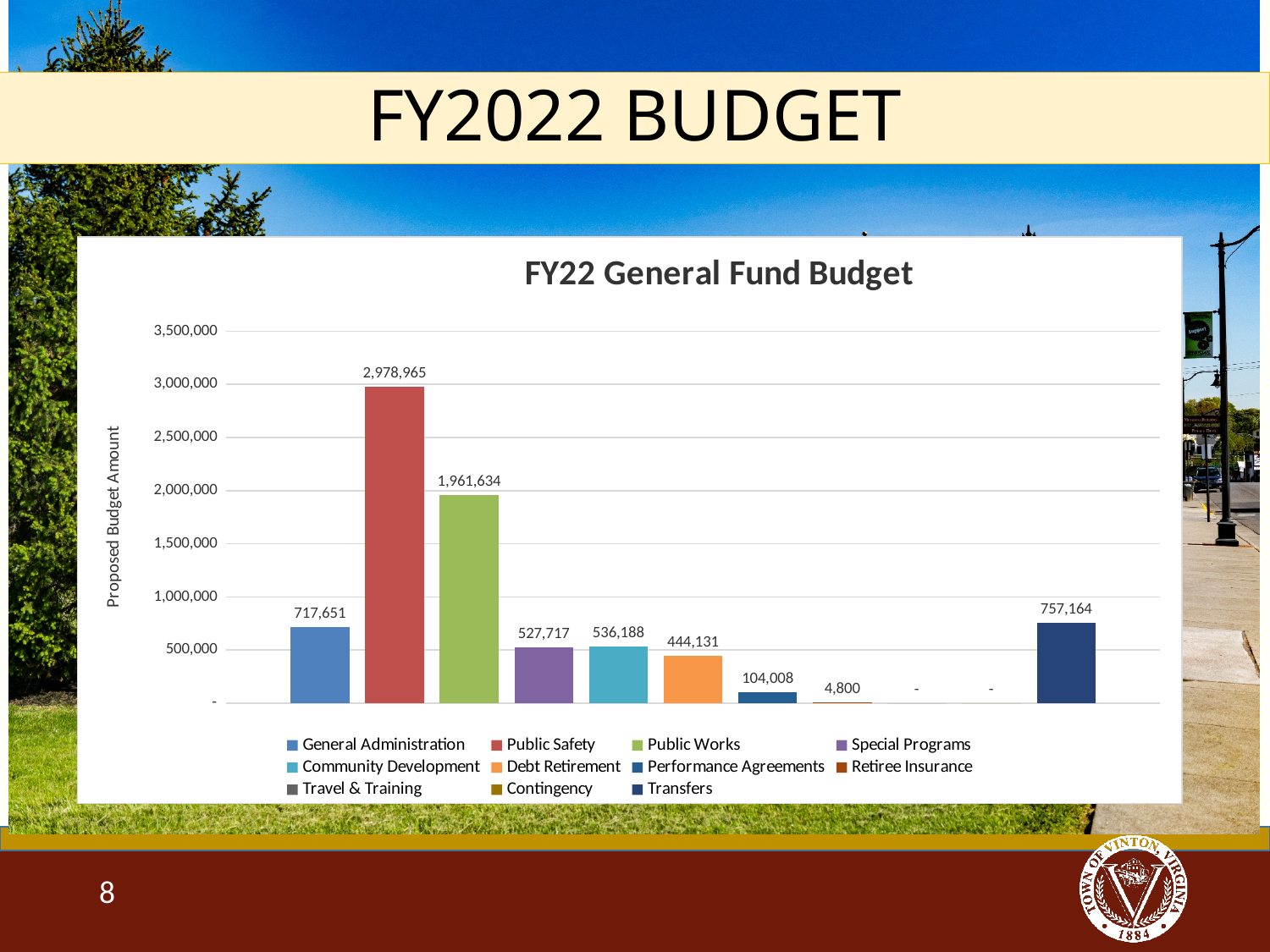
What is the proposed budget amount for Retiree Insurance? 4,800 How many entries does the legend list? 11 Which has a larger proposed budget amount, General Administration or Transfers? Transfers What kind of chart is shown on the slide? Bar chart Which budget category has the lowest non-zero proposed amount? Retiree Insurance What is the proposed budget amount for Public Safety in the FY22 General Fund Budget chart? 2,978,965 What is the title of the chart? FY22 General Fund Budget What is the proposed budget amount for Transfers? 757,164 What is the proposed budget amount for Public Works? 1,961,634 Is the value for Debt Retirement greater or less than 500,000? less Which budget category has the highest proposed amount? Public Safety What is the difference between the Public Safety and Public Works proposed budget amounts? 1,017,331